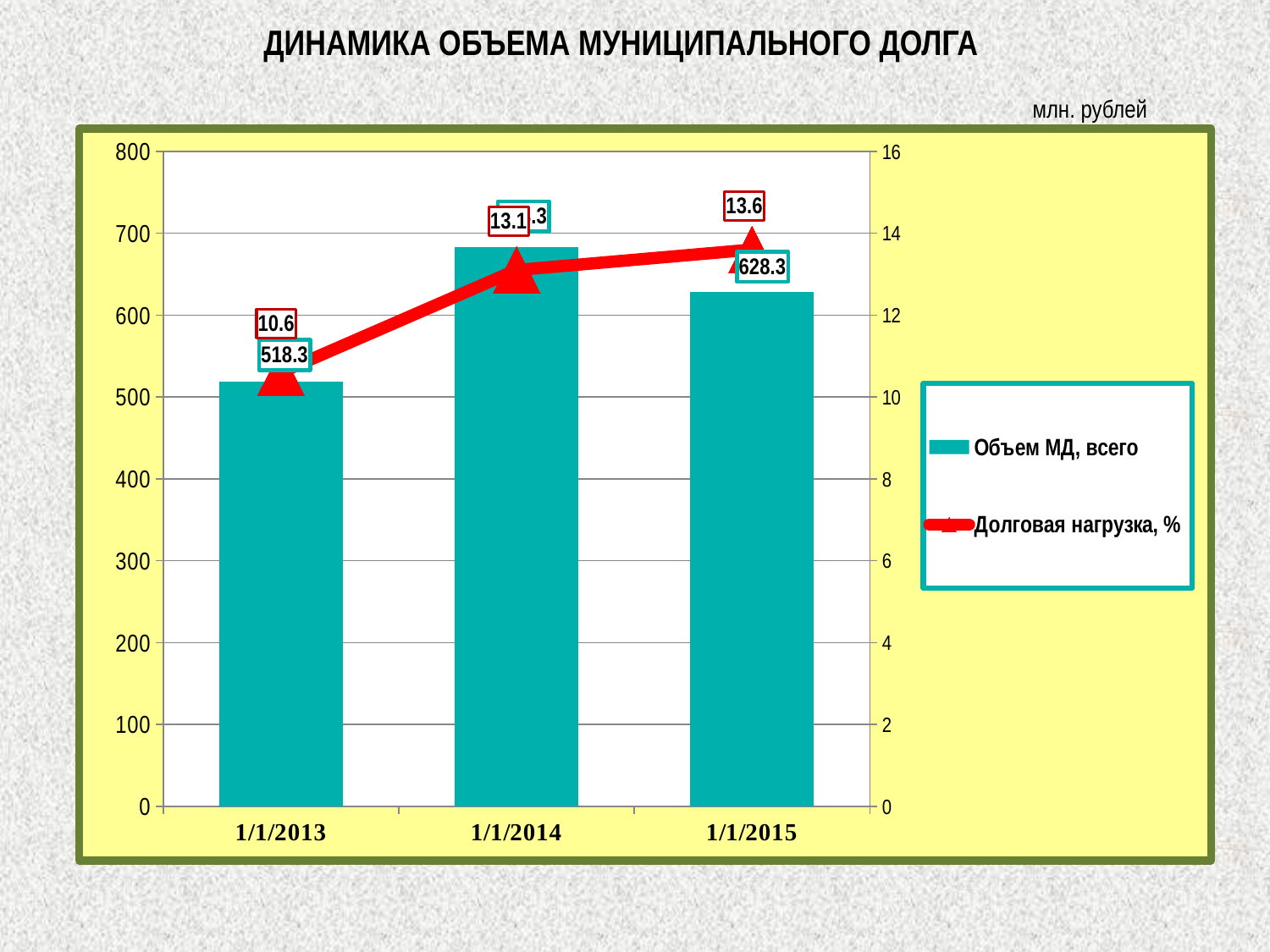
How many series does the legend list? 2 What is the title of the chart? ДИНАМИКА ОБЪЕМА МУНИЦИПАЛЬНОГО ДОЛГА By how much did Долговая нагрузка, % change from 1/1/2013 to 1/1/2015? 3 What is the difference between the Объем МД, всего values for 1/1/2015 and 1/1/2013? 110 What is the value of Объем МД, всего for 1/1/2015? 628.3 Which date has the lowest Долговая нагрузка, % value? 1/1/2013 Does Долговая нагрузка, % rise or fall from 1/1/2013 to 1/1/2015? rise Which date has the highest Объем МД, всего bar? 1/1/2014 Is the Объем МД, всего bar for 1/1/2014 greater or less than 600? greater What is the Долговая нагрузка, % value for 1/1/2015? 13.6 What is the value of Объем МД, всего for 1/1/2013? 518.3 What is the Долговая нагрузка, % value for 1/1/2014? 13.1